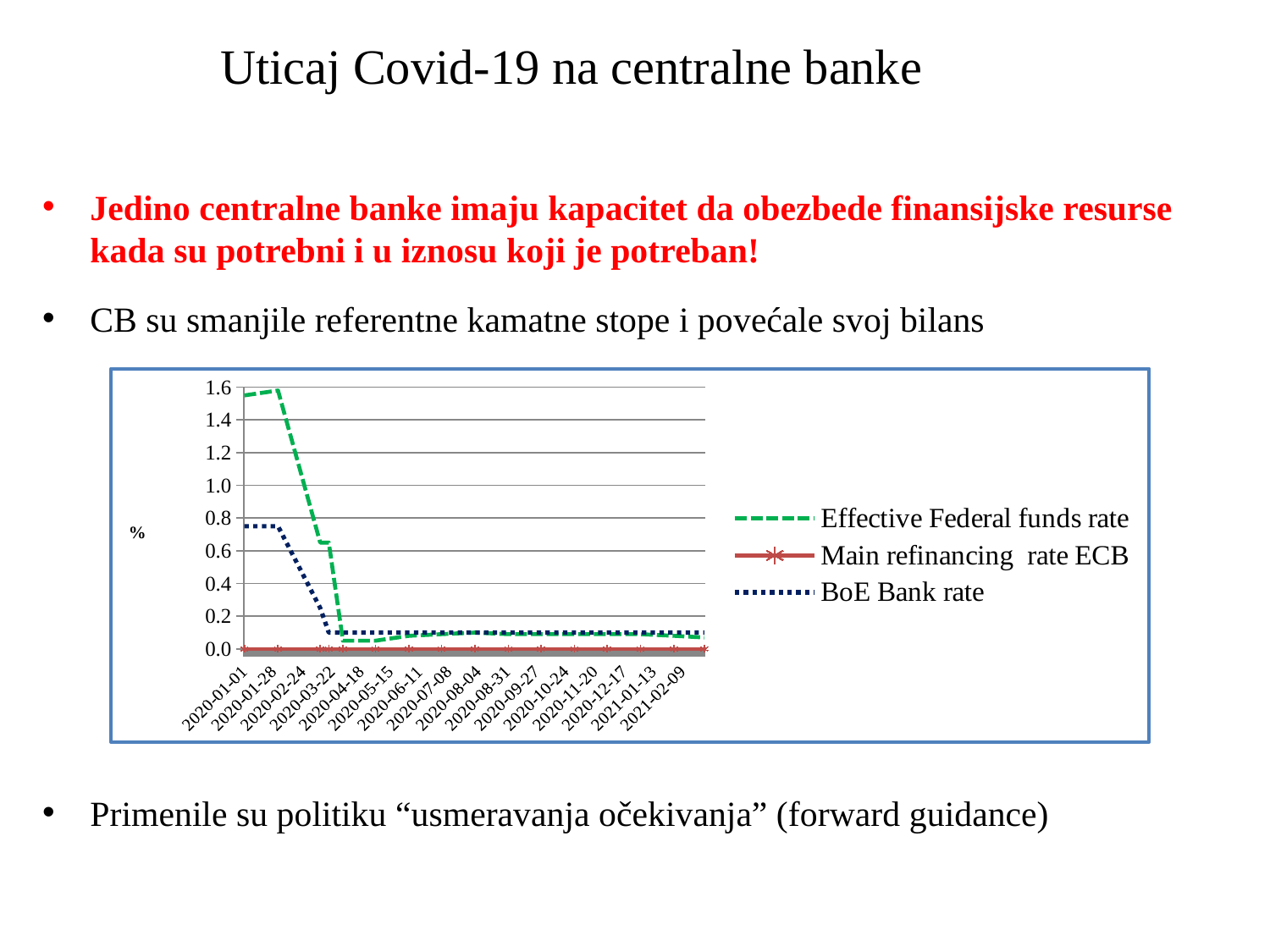
What kind of chart is shown on the slide? line chart Is the BoE Bank rate at 2020-01-01 greater or less than 0.6? greater Does the Effective Federal funds rate rise or fall between 2020-01-01 and 2020-04-18? fall How many series does the chart's legend list? 3 What is the label on the vertical axis of the chart? % At 2020-01-01, which is larger: the Effective Federal funds rate or the BoE Bank rate? Effective Federal funds rate Which series has the highest value at 2020-01-01? Effective Federal funds rate Which series does the green dashed line represent? Effective Federal funds rate Is the Main refinancing rate ECB at 2020-08-04 greater or less than 0.2? less Which series has the lowest value at 2020-01-01? Main refinancing rate ECB Is the BoE Bank rate at 2020-08-04 greater or less than 0.4? less